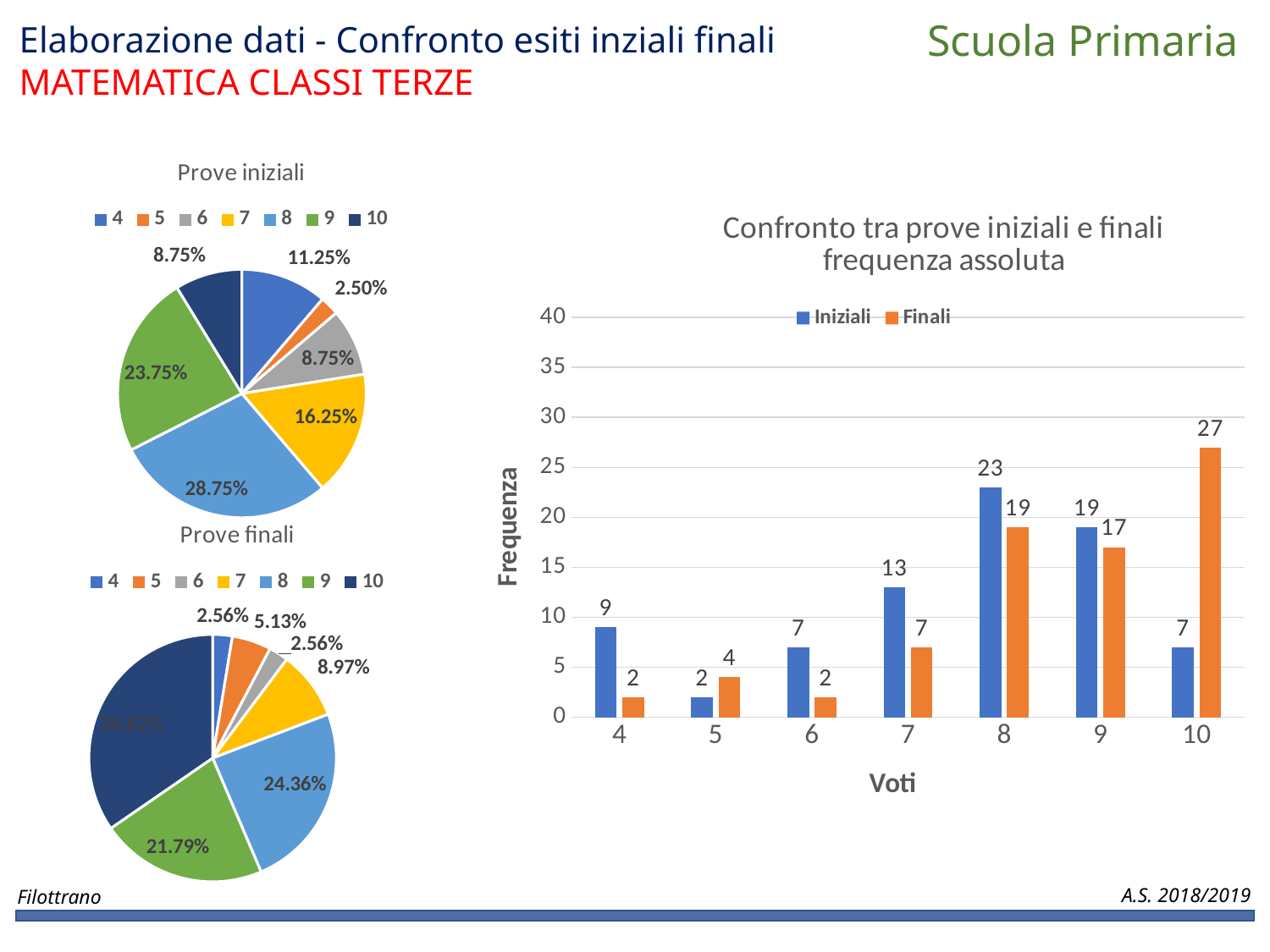
In the 'Confronto tra prove iniziali e finali frequenza assoluta' bar chart, which Voti has the highest Finali value? 10 In the 'Prove finali' pie chart, what share does category 9 have? 21.79% How many categories does the legend of the 'Prove finali' pie chart list? 7 In the 'Prove iniziali' pie chart, what share does category 8 have? 28.75% What kind of chart is the 'Confronto tra prove iniziali e finali frequenza assoluta' chart? bar chart In the 'Confronto tra prove iniziali e finali frequenza assoluta' bar chart, which Voti has the lowest Iniziali value? 5 In the 'Confronto tra prove iniziali e finali frequenza assoluta' bar chart, what is the Iniziali value for Voti 8? 23 In the 'Confronto tra prove iniziali e finali frequenza assoluta' bar chart, what is the Finali value for Voti 10? 27 How many series does the legend of the 'Confronto tra prove iniziali e finali frequenza assoluta' chart list? 2 In the 'Confronto tra prove iniziali e finali frequenza assoluta' bar chart, which is larger for Voti 9: Iniziali or Finali? Iniziali In the 'Confronto tra prove iniziali e finali frequenza assoluta' bar chart, what is the difference between the Iniziali and Finali values for Voti 7? 6 In the 'Prove iniziali' pie chart, which category has the smallest slice? 5